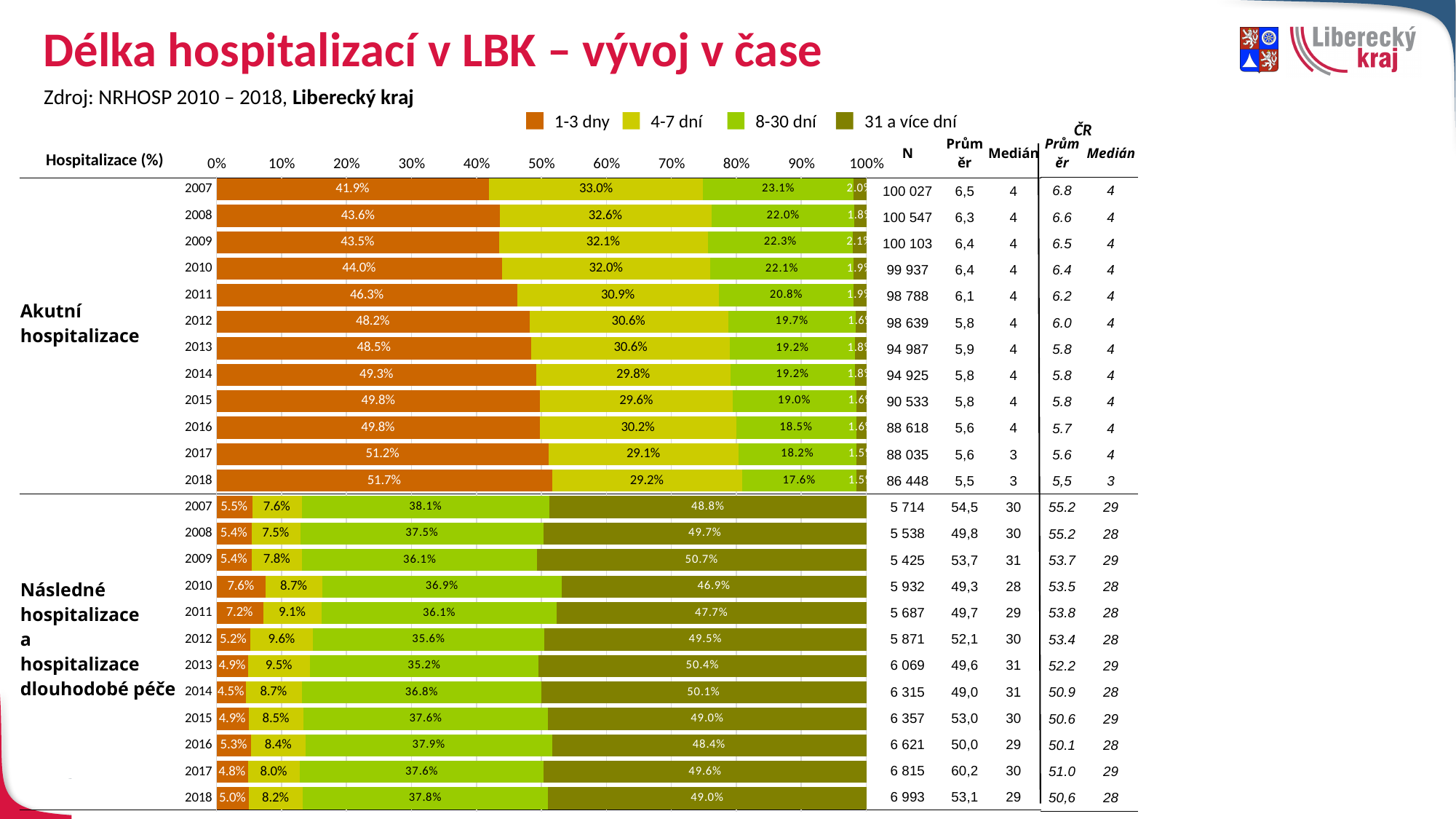
In the Akutní hospitalizace section, does the share of 8-30 dní hospitalizations rise or fall from 2007 to 2018? Falls What kind of chart is shown on the slide? Stacked bar chart In the Následné hospitalizace section, which year has the lowest share of 1-3 dny hospitalizations? 2014 How many series does the chart legend list? 4 In the Následné hospitalizace section, which year has the larger share of 31 a více dní hospitalizations, 2009 or 2010? 2009 In the Akutní hospitalizace section, by how many percentage points is the 1-3 dny share in 2018 higher than in 2007? 9.8 percentage points How many years are plotted in the Akutní hospitalizace section of the chart? 12 In the Akutní hospitalizace section, what share of hospitalizations in 2007 lasted 1-3 dny? 41.9% In the Akutní hospitalizace section, does the share of 1-3 dny hospitalizations rise or fall from 2007 to 2018? Rises In the Následné hospitalizace section, what share of hospitalizations in 2018 lasted 31 a více dní? 49.0% In the Akutní hospitalizace section, what share of hospitalizations in 2012 lasted 4-7 dní? 30.6% In the Akutní hospitalizace section, which year has the highest share of 1-3 dny hospitalizations? 2018